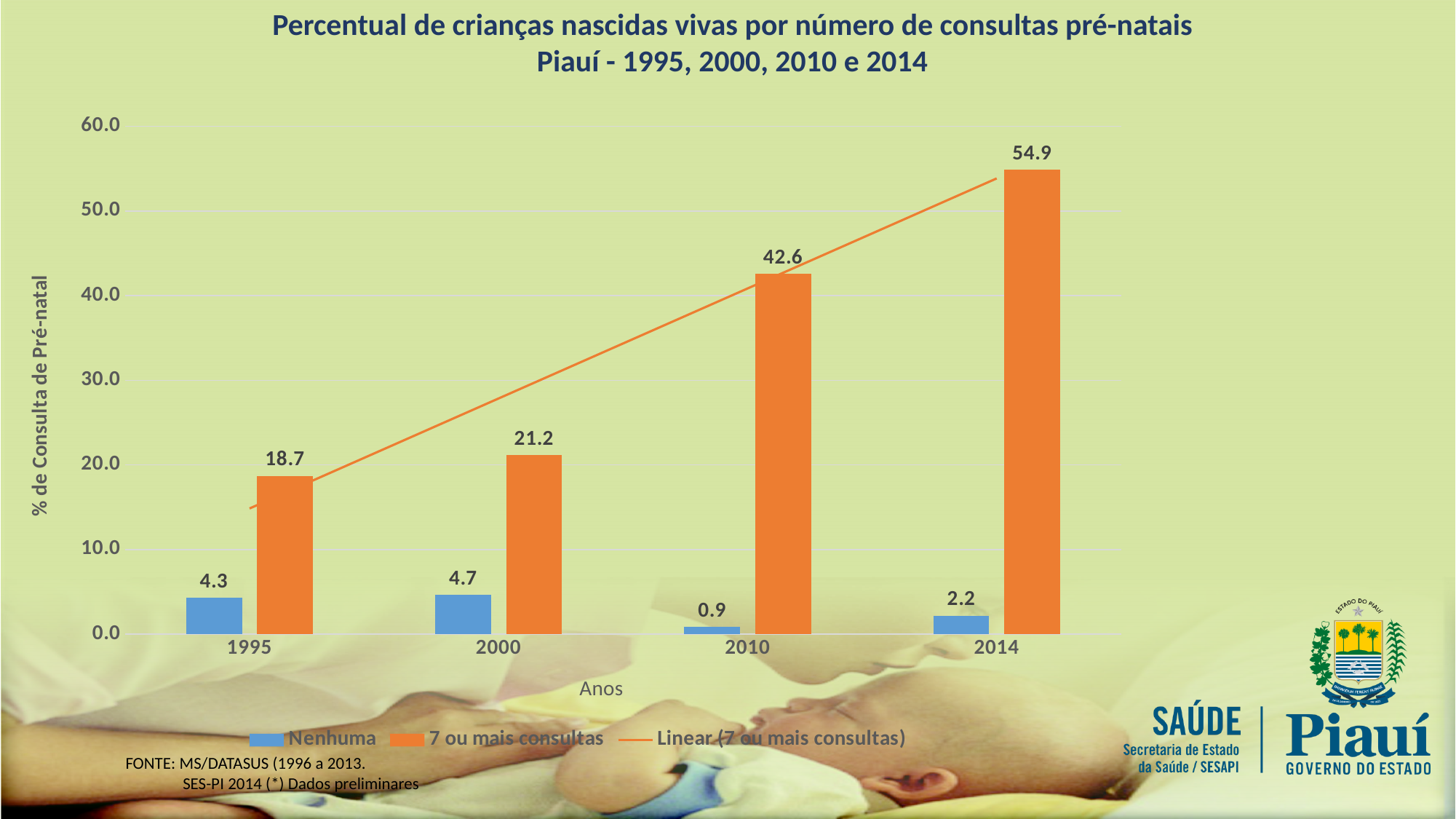
Which year has the highest value for "7 ou mais consultas"? 2014 What is the value for "Nenhuma" in 2010? 0.9 How many entries does the legend list? 3 Which is larger: the "Nenhuma" value for 1995 or for 2000? 2000 What kind of chart is shown on the slide? bar chart What is the value for "7 ou mais consultas" in 2014? 54.9 Do the values for "7 ou mais consultas" rise or fall from 1995 to 2014? rise What is the difference between the "7 ou mais consultas" values for 2014 and 2010? 12.3 Which year has the lowest value for "Nenhuma"? 2010 What is the value for "7 ou mais consultas" in 1995? 18.7 How many years are shown on the x axis? 4 Is the value for "7 ou mais consultas" in 2010 greater or less than 40.0? greater